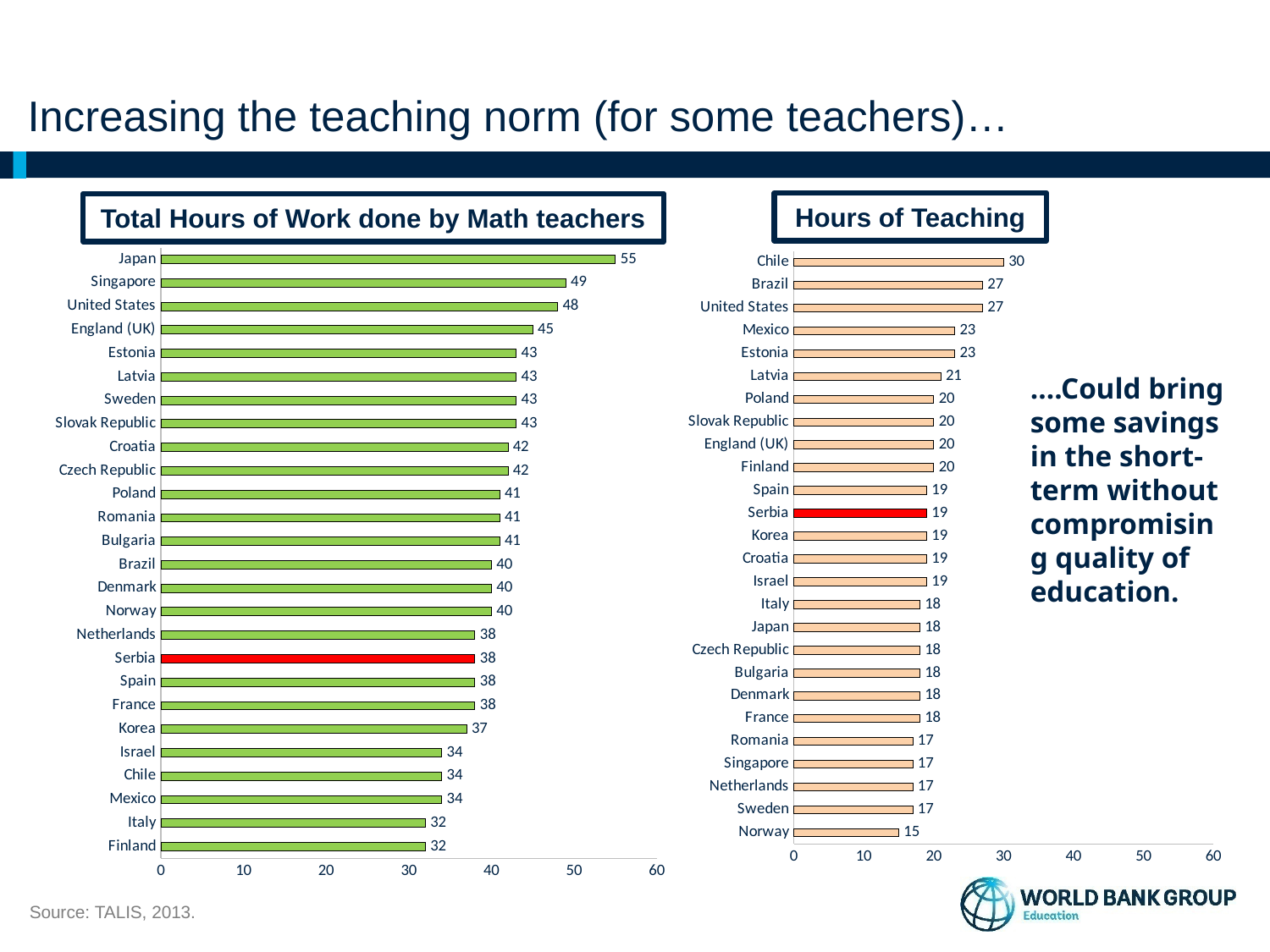
In the 'Total Hours of Work done by Math teachers' chart, what is the value for England (UK)? 45 In the 'Total Hours of Work done by Math teachers' chart, what is the value for Serbia? 38 How many countries are shown in the 'Hours of Teaching' chart? 26 In the 'Total Hours of Work done by Math teachers' chart, which country has the highest value? Japan In the 'Hours of Teaching' chart, which country has the lowest value? Norway In the 'Hours of Teaching' chart, which country's bar is highlighted in red? Serbia In the 'Hours of Teaching' chart, is the value for Brazil greater or less than 20? greater In the 'Total Hours of Work done by Math teachers' chart, which is larger, the value for Singapore or the value for Korea? Singapore What type of chart is the 'Total Hours of Work done by Math teachers' chart? Bar chart In the 'Hours of Teaching' chart, what is the difference between Chile and Serbia? 11 In the 'Total Hours of Work done by Math teachers' chart, what is the difference between Japan and Finland? 23 In the 'Hours of Teaching' chart, what is the value for Chile? 30